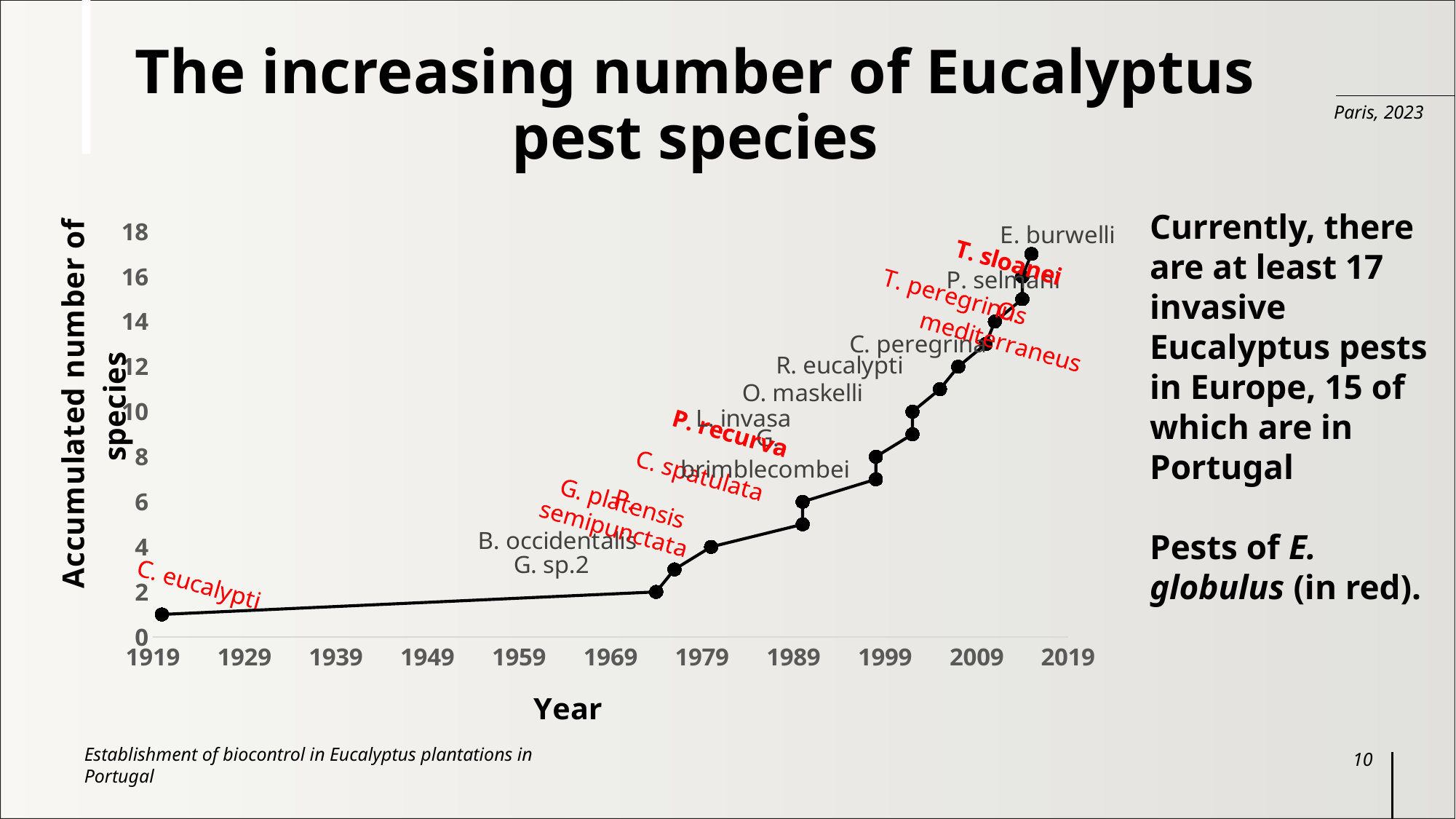
What is the highest value shown on the y axis? 18 Which species label is attached to the highest point on the line? E. burwelli How many data points are plotted on the line? 17 What is the title of the chart's x axis? Year Is the value of the highest point on the line (labelled E. burwelli) greater or less than 16? greater What is the first year shown on the x axis? 1919 Which species label is attached to the lowest point on the line? C. eucalypti Which is larger: the value at the point labelled C. eucalypti or the value at the point labelled E. burwelli? E. burwelli Does the accumulated number of species rise or fall as the year increases? rises What kind of chart is shown on the slide? line chart Is the value plotted for 1919 greater or less than 2? less What is the title of the chart's y axis? Accumulated number of species